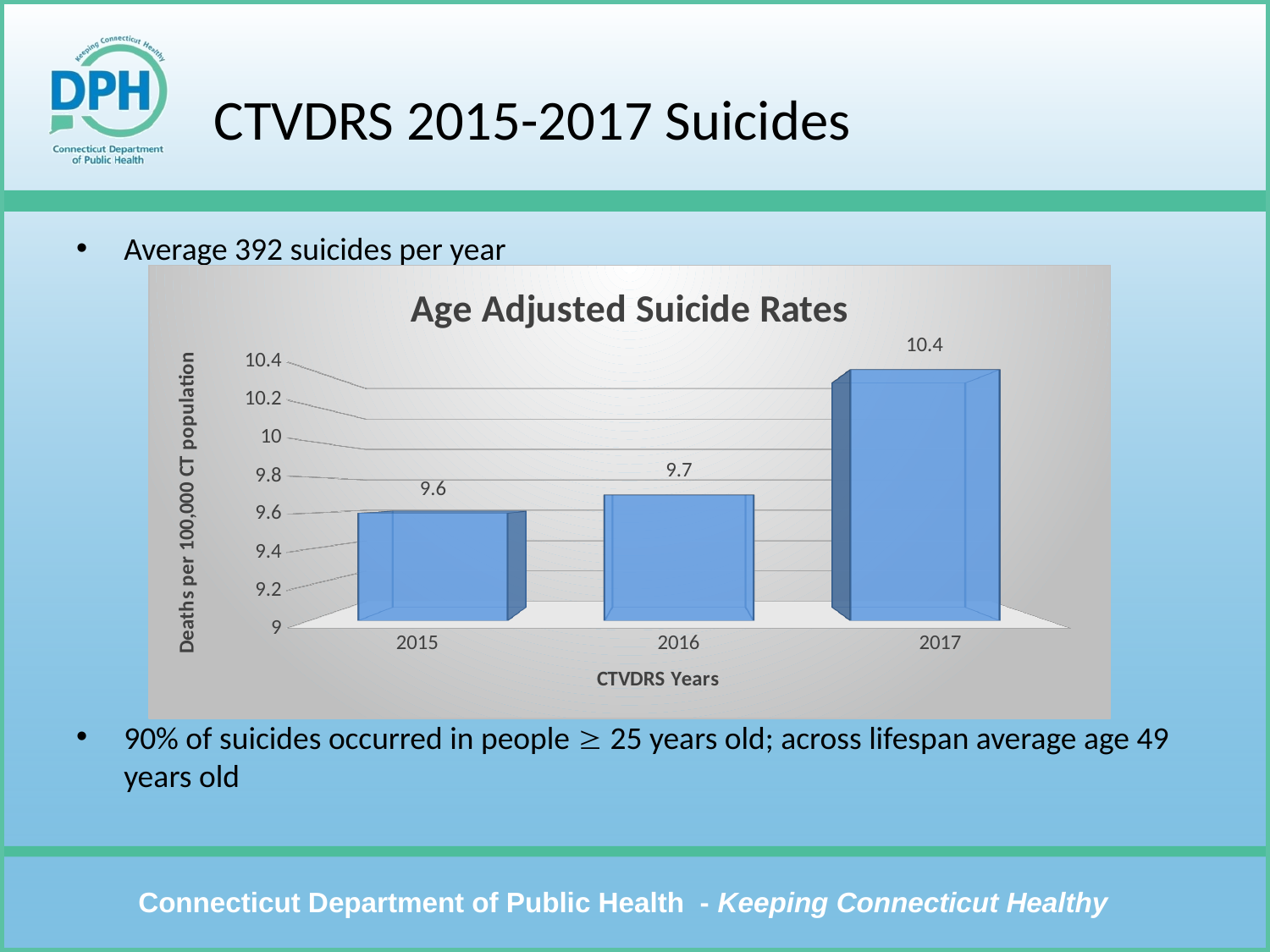
What is the difference between the 2016 and 2015 age adjusted suicide rates? 0.1 Is the age adjusted suicide rate higher in 2017 or in 2016? 2017 How many years are shown on the chart? 3 Which year has the highest age adjusted suicide rate? 2017 What kind of chart is shown on the slide? bar chart Is the value for 2017 greater or less than 10? greater Which year has the lowest age adjusted suicide rate? 2015 What is the age adjusted suicide rate for 2016? 9.7 What is the age adjusted suicide rate for 2017? 10.4 What is the age adjusted suicide rate for 2015? 9.6 What is the difference between the 2017 and 2015 age adjusted suicide rates? 0.8 Do the age adjusted suicide rates rise or fall from 2015 to 2017? rise